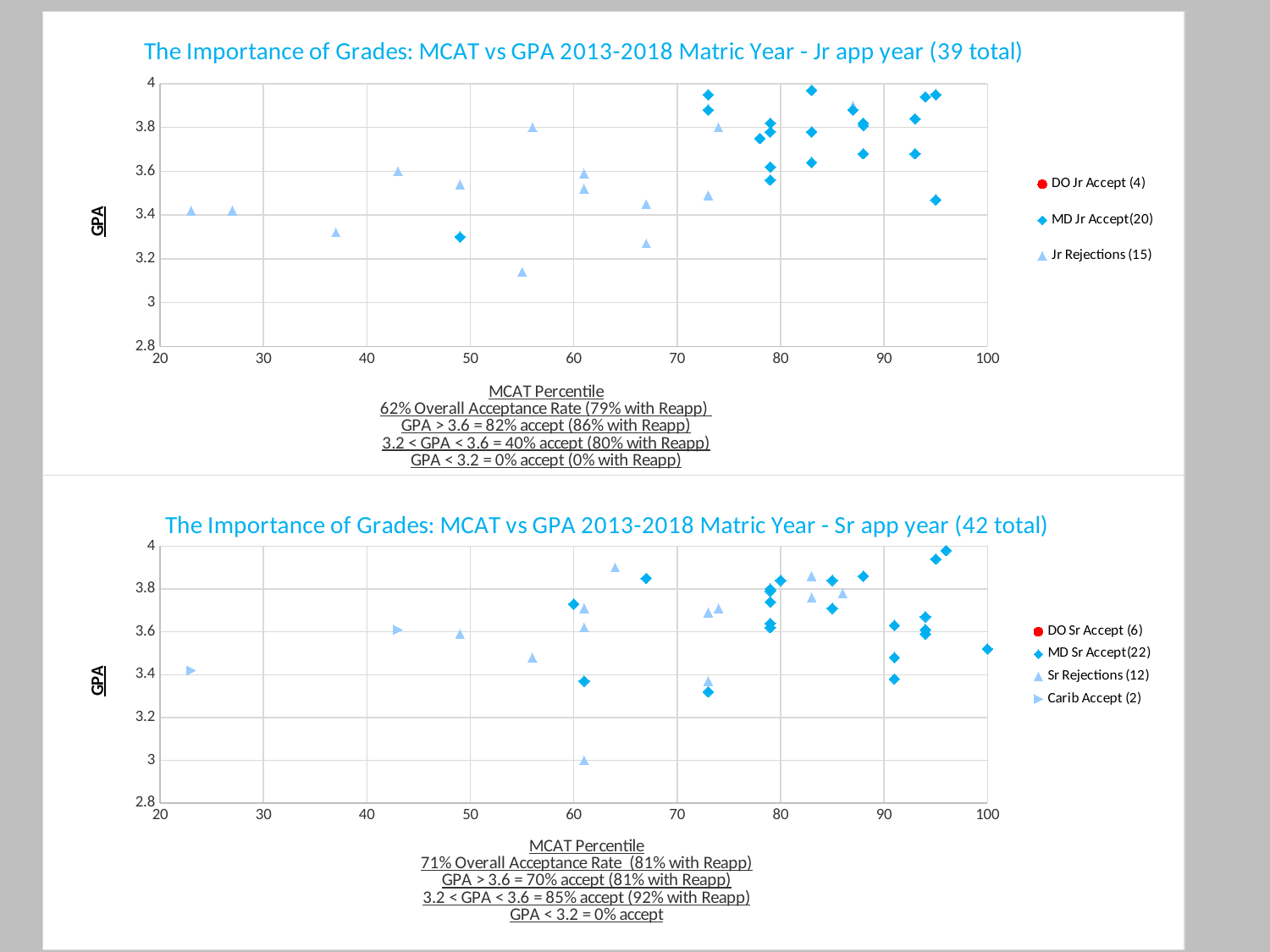
How many series does the legend of the top chart (Jr app year) list? 3 What kind of chart is the top chart, 'Jr app year (39 total)'? scatter chart In the top chart (Jr app year), is the GPA of the lowest plotted point (near MCAT percentile 55) greater or less than 3.2? less What is the x-axis title of the bottom chart (Sr app year)? MCAT Percentile How many series does the legend of the bottom chart (Sr app year) list? 4 In the bottom chart (Sr app year), is the GPA of the lowest plotted point (near MCAT percentile 61) greater or less than 3.2? less In the bottom chart's legend, how many applicants are in the 'Sr Rejections' series? 12 According to the title of the top chart, how many applicants in total are plotted for the Jr app year? 39 What is the y-axis title of the top chart (Jr app year)? GPA In the bottom chart's legend, how many applicants are in the 'Carib Accept' series? 2 According to the title of the bottom chart, how many applicants in total are plotted for the Sr app year? 42 In the top chart's legend, how many applicants are in the 'MD Jr Accept' series? 20